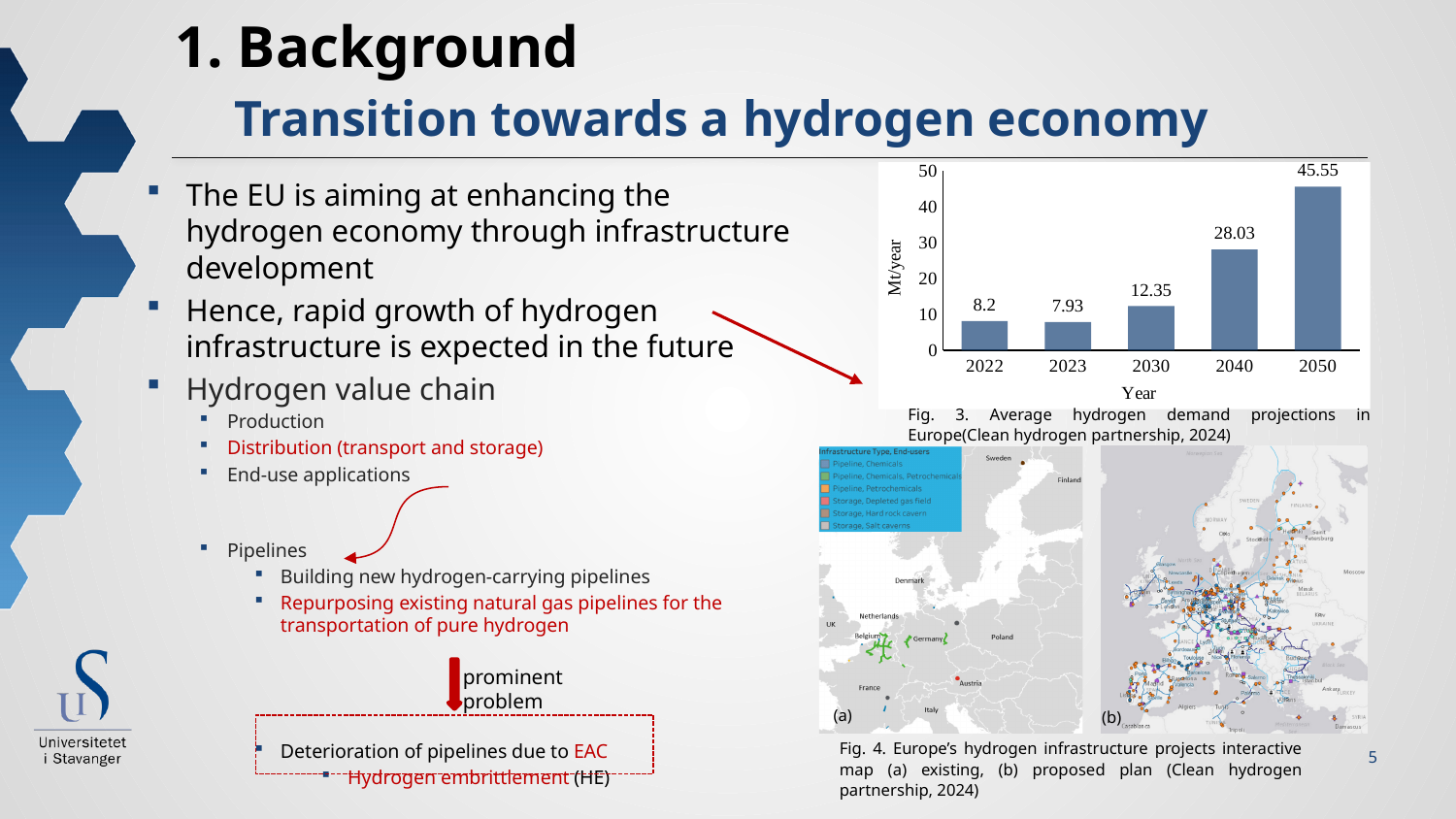
What type of chart is Fig. 3? bar chart What is the difference between the 2050 and 2040 values in the bar chart? 17.52 Which year has the lowest hydrogen demand in the bar chart? 2023 What is the unit shown on the y axis of the bar chart? Mt/year What is the hydrogen demand value shown for 2030 in the bar chart? 12.35 Which year has the highest hydrogen demand in the bar chart? 2050 How many years are shown on the x axis of the bar chart? 5 What is the hydrogen demand value shown for 2022 in the bar chart? 8.2 In the bar chart, which is larger: the value for 2040 or the value for 2030? 2040 What is the difference between the 2030 and 2022 values in the bar chart? 4.15 What is the hydrogen demand value shown for 2050 in the bar chart? 45.55 Is the value for 2040 in the bar chart greater or less than 20? greater